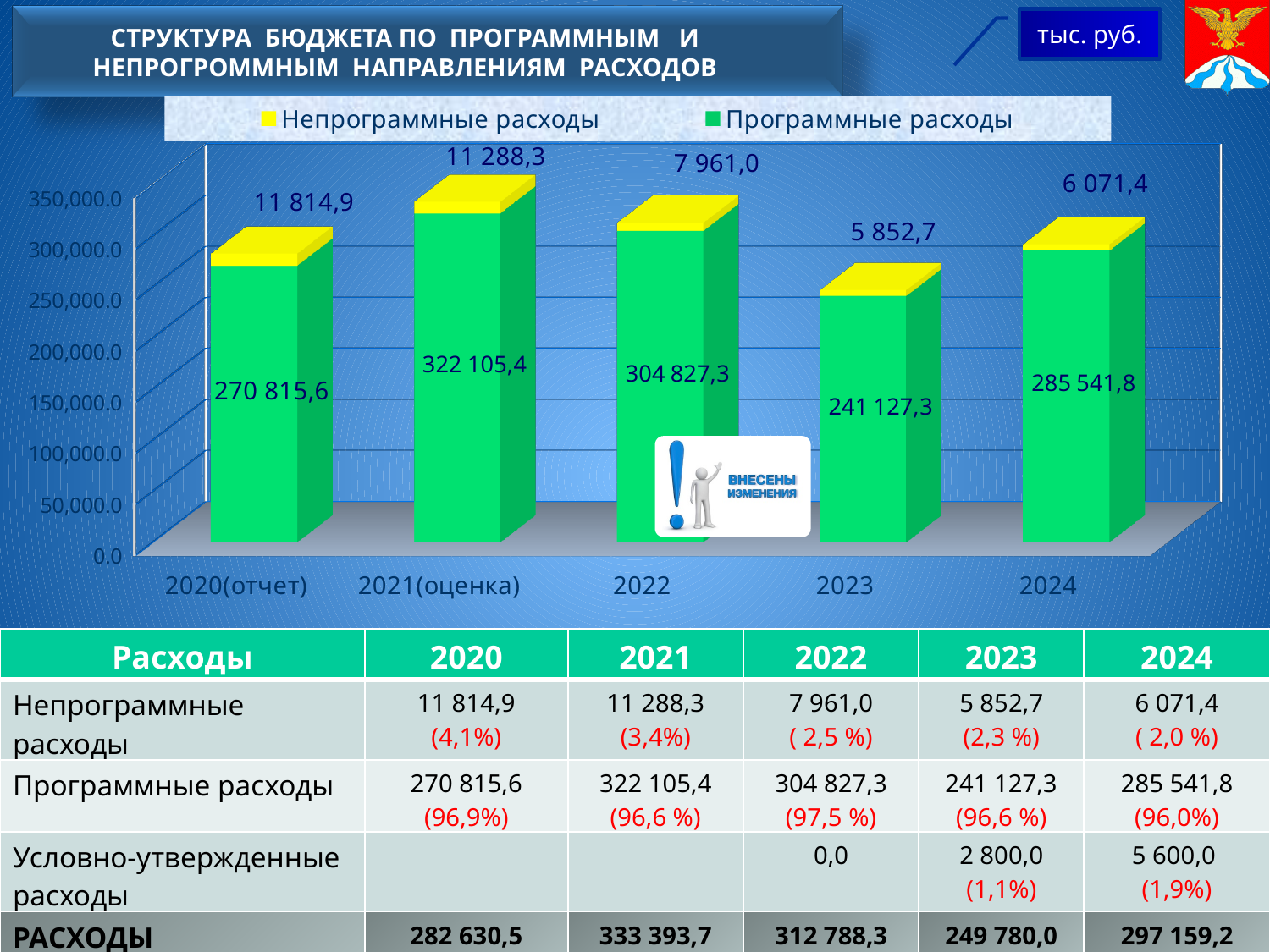
How many series does the chart legend list? 2 Which series is shown in yellow in the chart? Непрограммные расходы Which year has the highest value of Программные расходы? 2021(оценка) What is the total of the stacked bar for 2020(отчет)? 282 630,5 Is the value of Программные расходы for 2023 greater or less than 250,000.0? less Which is larger: Программные расходы in 2022 or in 2024? 2022 How many categories (years) are shown on the x axis of the chart? 5 What is the value of Программные расходы for 2022? 304 827,3 What is the value of Непрограммные расходы for 2024? 6 071,4 Which year has the lowest value of Непрограммные расходы? 2023 What type of chart is shown on the slide? Stacked bar chart What is the difference between Программные расходы in 2021(оценка) and 2020(отчет)? 51 289,8